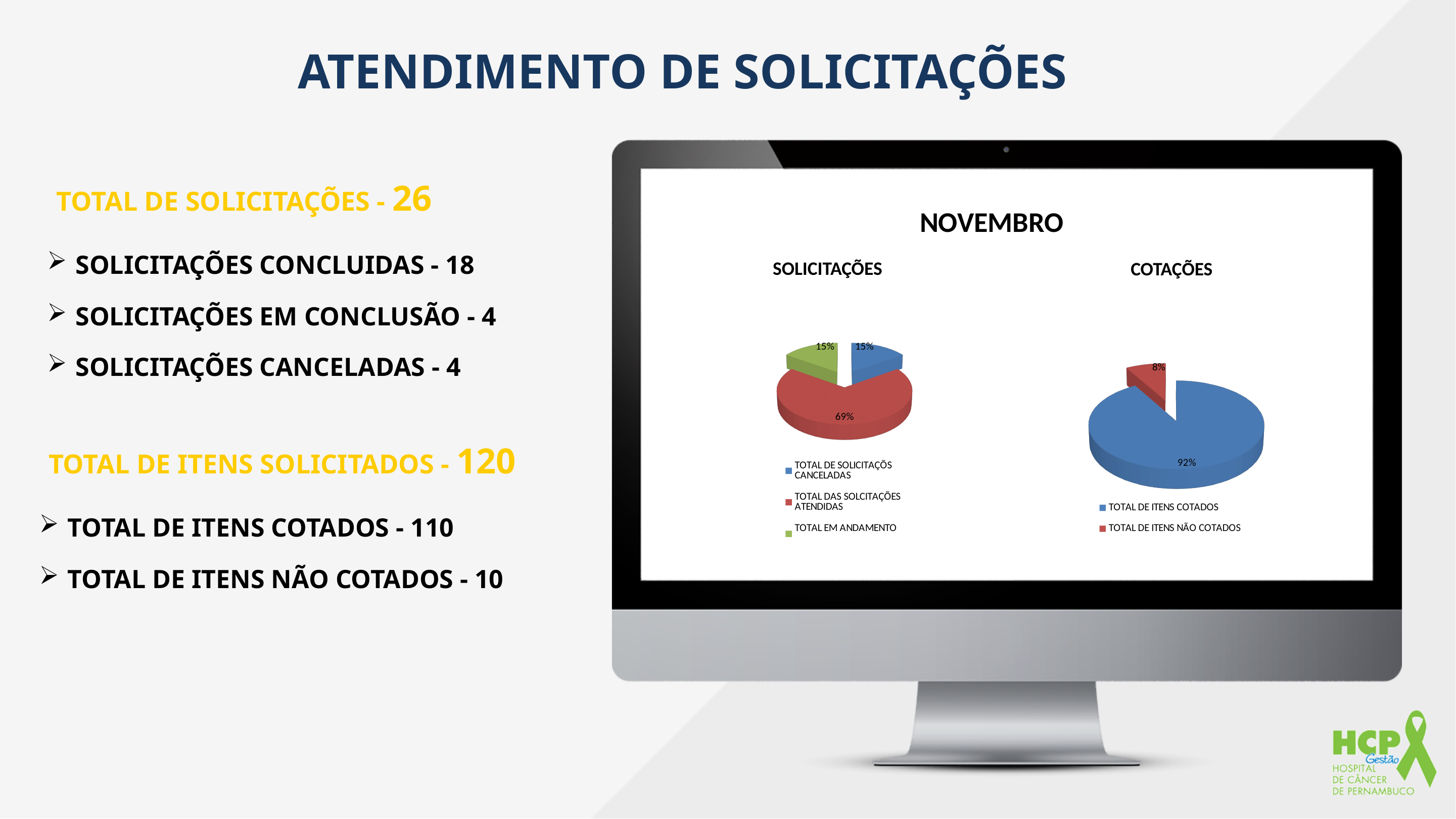
In the COTAÇÕES chart, what is the difference in percentage points between TOTAL DE ITENS COTADOS and TOTAL DE ITENS NÃO COTADOS? 84 In the COTAÇÕES chart, what share is labelled for TOTAL DE ITENS COTADOS? 92% What colour is the TOTAL EM ANDAMENTO slice in the SOLICITAÇÕES chart? green In the SOLICITAÇÕES chart, what share is labelled for TOTAL DAS SOLCITAÇÕES ATENDIDAS? 69% In the COTAÇÕES chart, which category has the smallest slice? TOTAL DE ITENS NÃO COTADOS In the SOLICITAÇÕES chart, what share is labelled for TOTAL EM ANDAMENTO? 15% In the SOLICITAÇÕES chart, which category has the largest slice? TOTAL DAS SOLCITAÇÕES ATENDIDAS What kind of chart is the SOLICITAÇÕES chart? pie chart How many slices does the SOLICITAÇÕES chart have? 3 How many entries does the legend of the COTAÇÕES chart list? 2